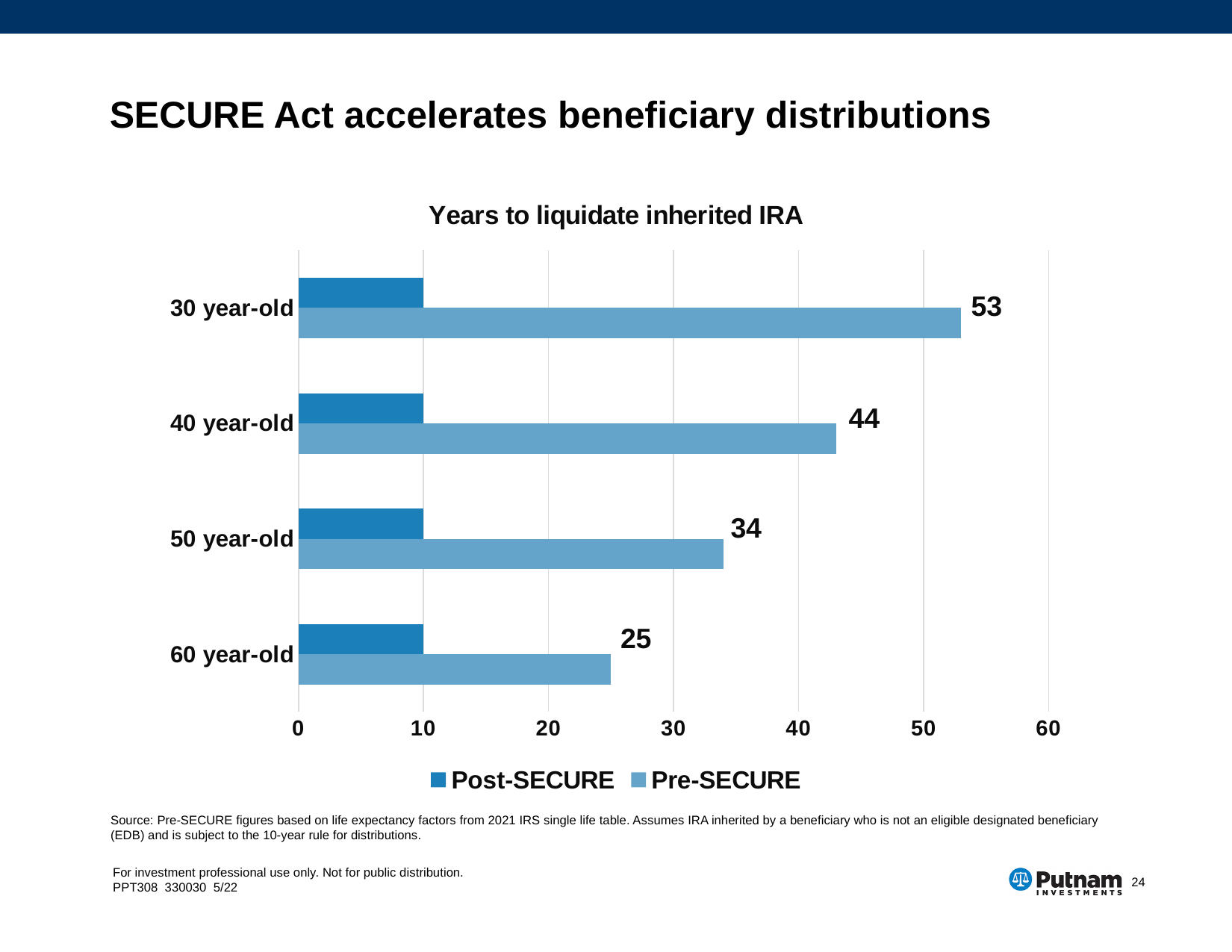
How many age categories are shown on the chart? 4 What kind of chart is shown on the slide? Bar chart Which is larger for a 50 year-old: the Pre-SECURE value or the Post-SECURE value? Pre-SECURE What is the Pre-SECURE value for a 60 year-old? 25 Is the Pre-SECURE value for a 40 year-old greater or less than 40? greater What is the Pre-SECURE value for a 30 year-old? 53 What is the Post-SECURE value for a 40 year-old? 10 Which age category has the lowest Pre-SECURE value? 60 year-old Which age category has the highest Pre-SECURE value? 30 year-old What is the Pre-SECURE value for a 50 year-old? 34 How many series does the legend list? 2 What is the difference between the Pre-SECURE values for a 30 year-old and a 40 year-old? 9